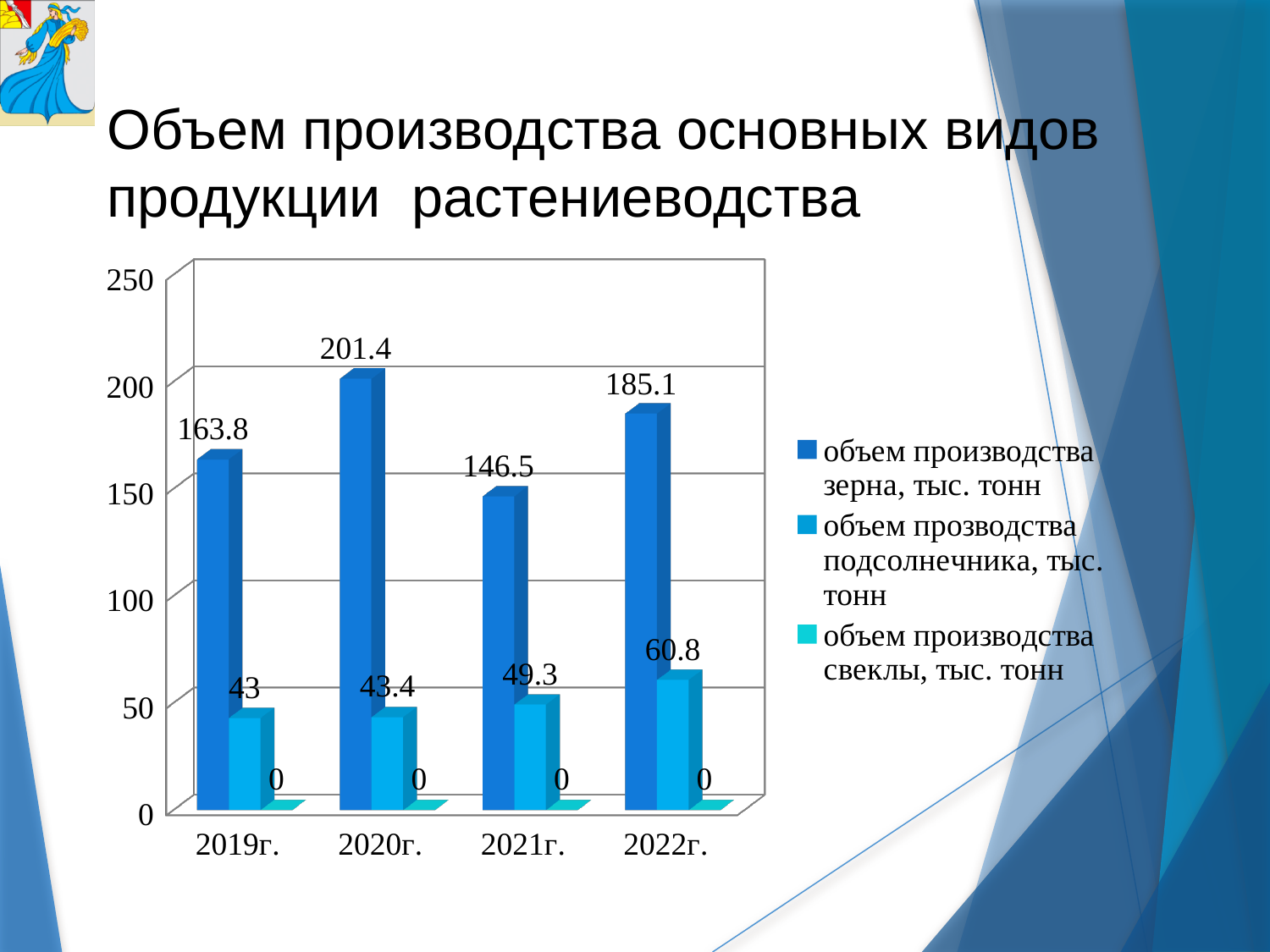
How many series does the legend list? 3 In which year is объем прозводства подсолнечника the highest? 2022г. What is the difference between объем производства зерна in 2020г. and in 2021г.? 54.9 Does объем прозводства подсолнечника rise or fall from 2020г. to 2022г.? rise How many years are shown on the x axis? 4 What is the value for объем производства зерна in 2020г.? 201.4 What is the value for объем производства свеклы in 2021г.? 0 Which is larger: объем производства зерна in 2019г. or in 2022г.? 2022г. What is the value for объем прозводства подсолнечника in 2022г.? 60.8 In which year is объем производства зерна the lowest? 2021г. What kind of chart is shown on the slide? bar chart In which year is объем производства зерна the highest? 2020г.